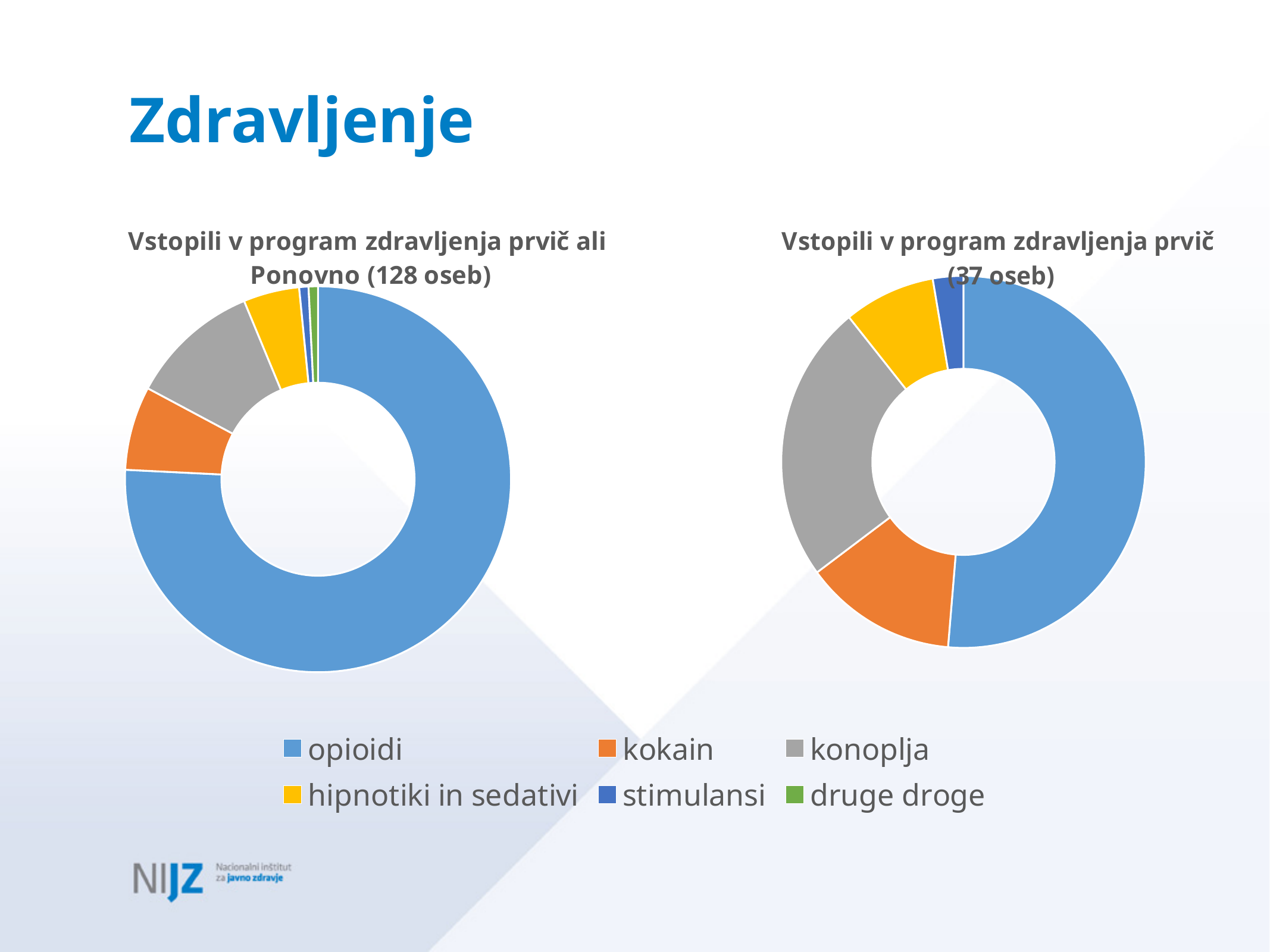
In the right chart (37 oseb), which category has the largest slice? opioidi In the left chart (128 oseb), which slice is larger: konoplja or kokain? konoplja In the right chart (37 oseb), which slice is larger: konoplja or hipnotiki in sedativi? konoplja How many slices does the left chart (128 oseb) have? 6 What kind of chart is the left chart, 'Vstopili v program zdravljenja prvič ali Ponovno (128 oseb)'? doughnut (pie) chart In the right chart (37 oseb), which category has the smallest slice? stimulansi What colour represents 'hipnotiki in sedativi' in the legend? yellow How many categories does the shared legend list? 6 In the right chart (37 oseb), which slice is larger: kokain or stimulansi? kokain How many slices does the right chart (37 oseb) have? 5 In the left chart (128 oseb), which category has the largest slice? opioidi